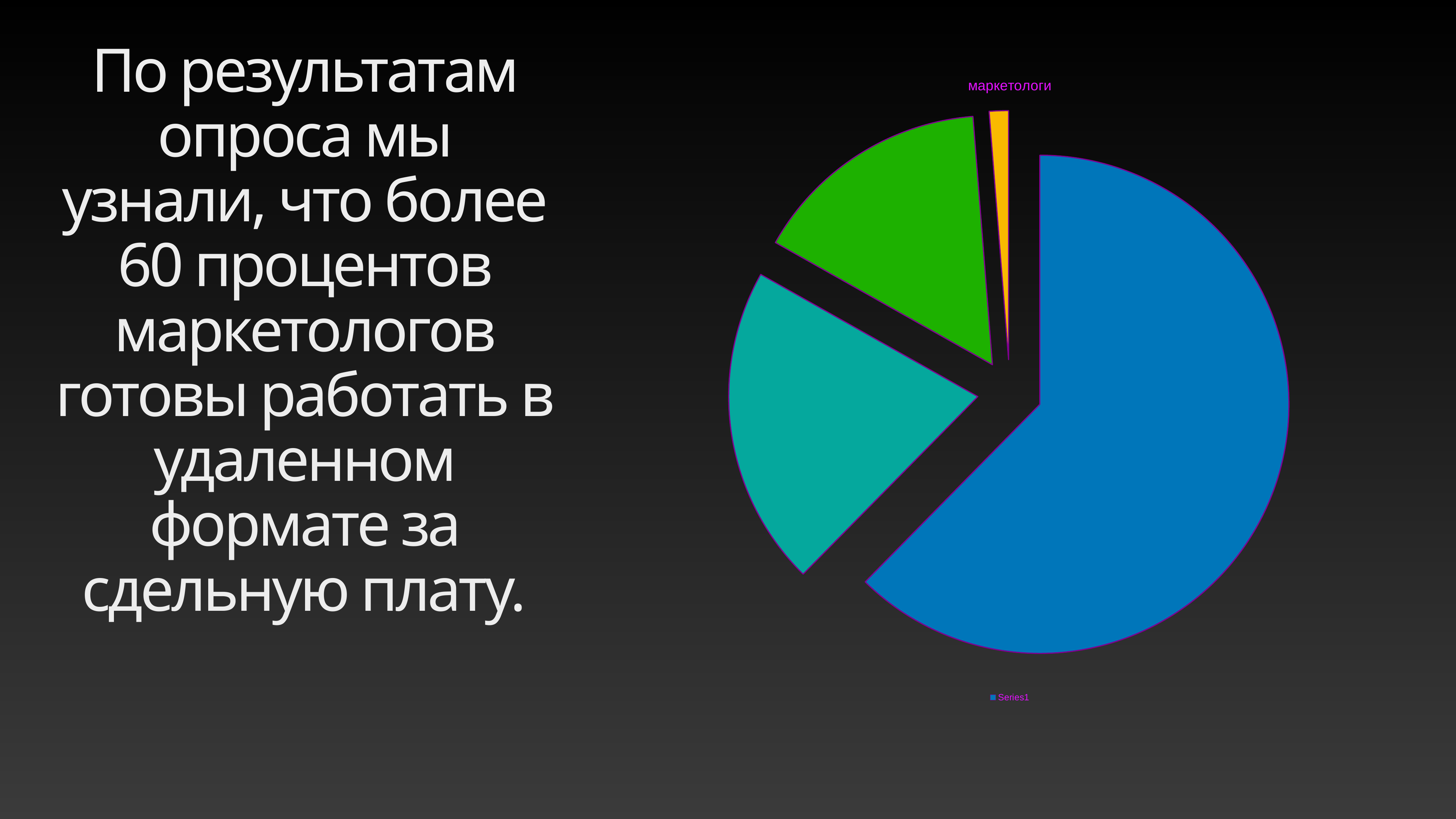
In the pie chart, which slice is larger, the teal one or the yellow one? teal Which colour slice is the smallest in the pie chart? yellow What is the name of the series shown in the legend of the pie chart? Series1 Which colour slice is the largest in the pie chart? blue What is the title of the pie chart? маркетологи How many slices does the pie chart have? 4 In the pie chart, which slice is larger, the blue one or the teal one? blue How many series does the legend of the pie chart list? 1 What kind of chart is shown on the slide? pie chart In the pie chart, which slice is larger, the green one or the yellow one? green